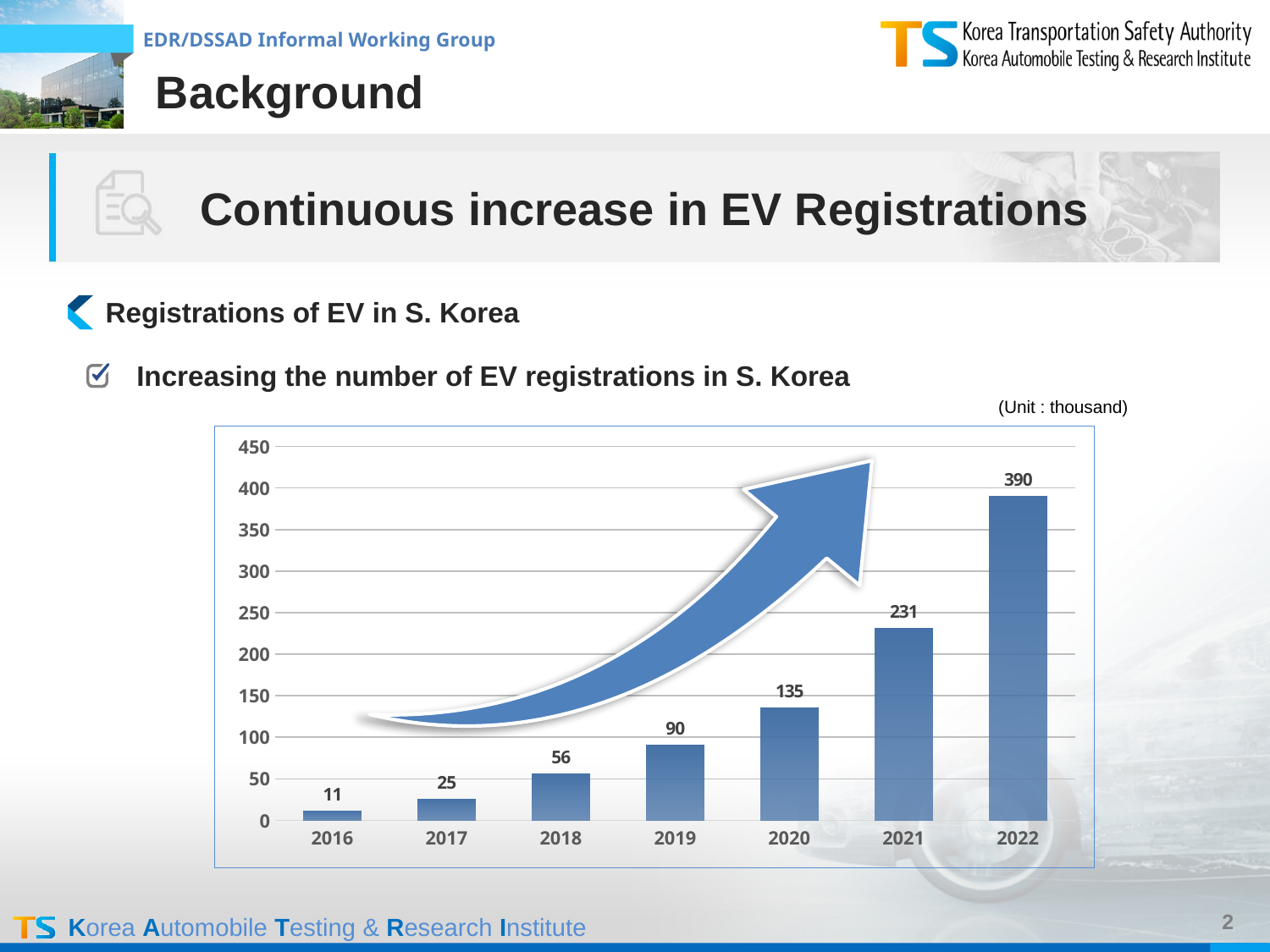
What is the value for 2016? 11 What is the value for 2021? 231 Is the value for 2022 greater or less than 350? greater Which year has the highest value? 2022 Do the values rise or fall from 2016 to 2022? rise Which year has the lowest value? 2016 What is the difference between the values for 2018 and 2017? 31 What kind of chart is shown? bar chart How many years are shown on the x axis? 7 Which is larger, the value for 2020 or the value for 2019? 2020 What is the value for 2019? 90 What is the difference between the values for 2022 and 2021? 159